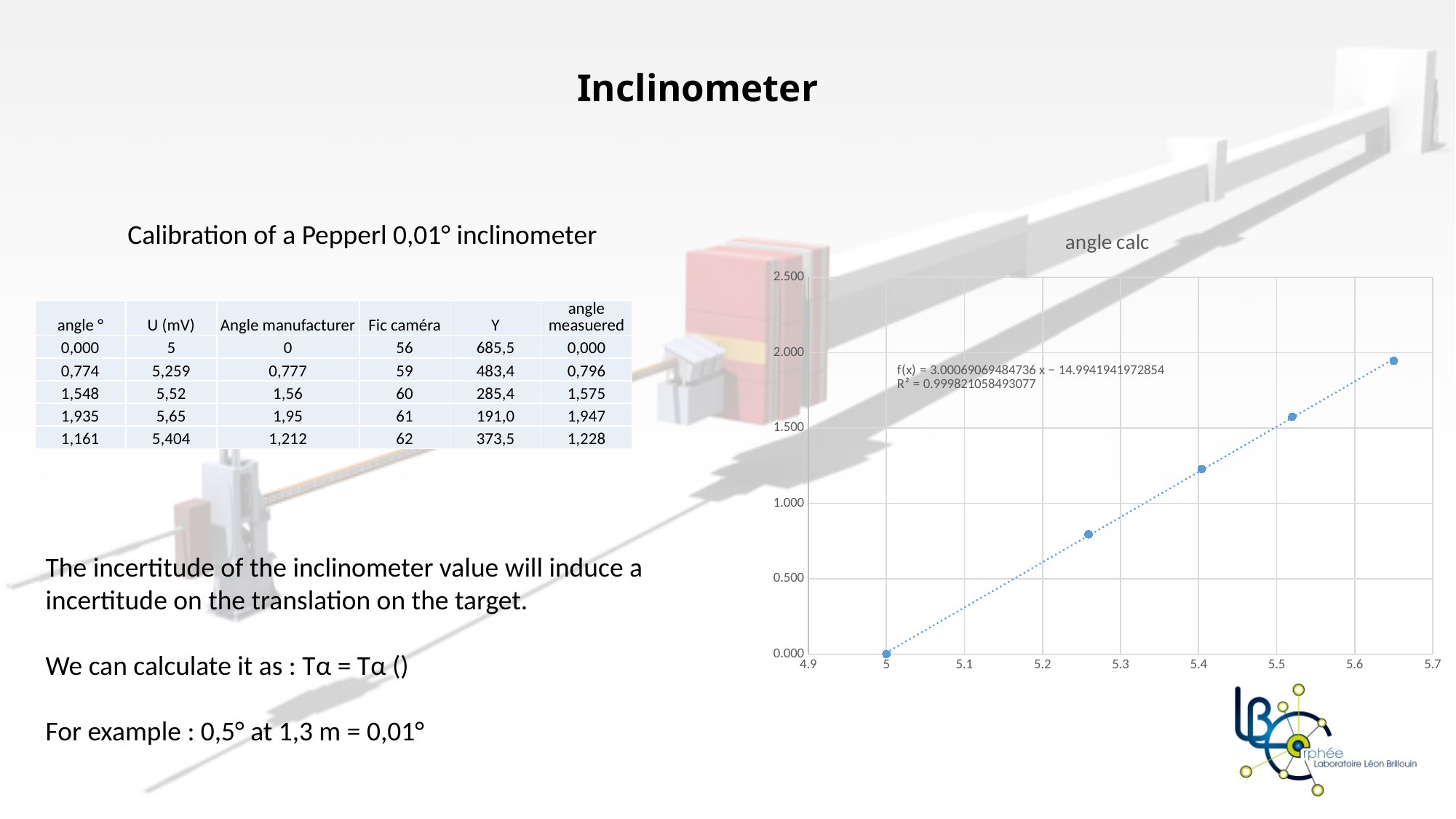
How many data points are plotted on the chart? 5 What is the title of the chart? angle calc What kind of chart is shown on the slide? scatter chart What is the slope of the trendline equation f(x) printed on the chart? 3.00069069484736 Is the y value of the data point nearest x = 5.5 greater or less than 2.000? less Is the y value of the rightmost data point greater or less than 1.500? greater What is the y value of the data point at x = 5? 0.000 Which data point has the highest y value, the leftmost or the rightmost? the rightmost What is the R² value printed on the chart? 0.999821058493077 Is the y value of the data point nearest x = 5.4 greater or less than 1.000? greater Do the plotted values rise or fall as x increases along the x axis? rise